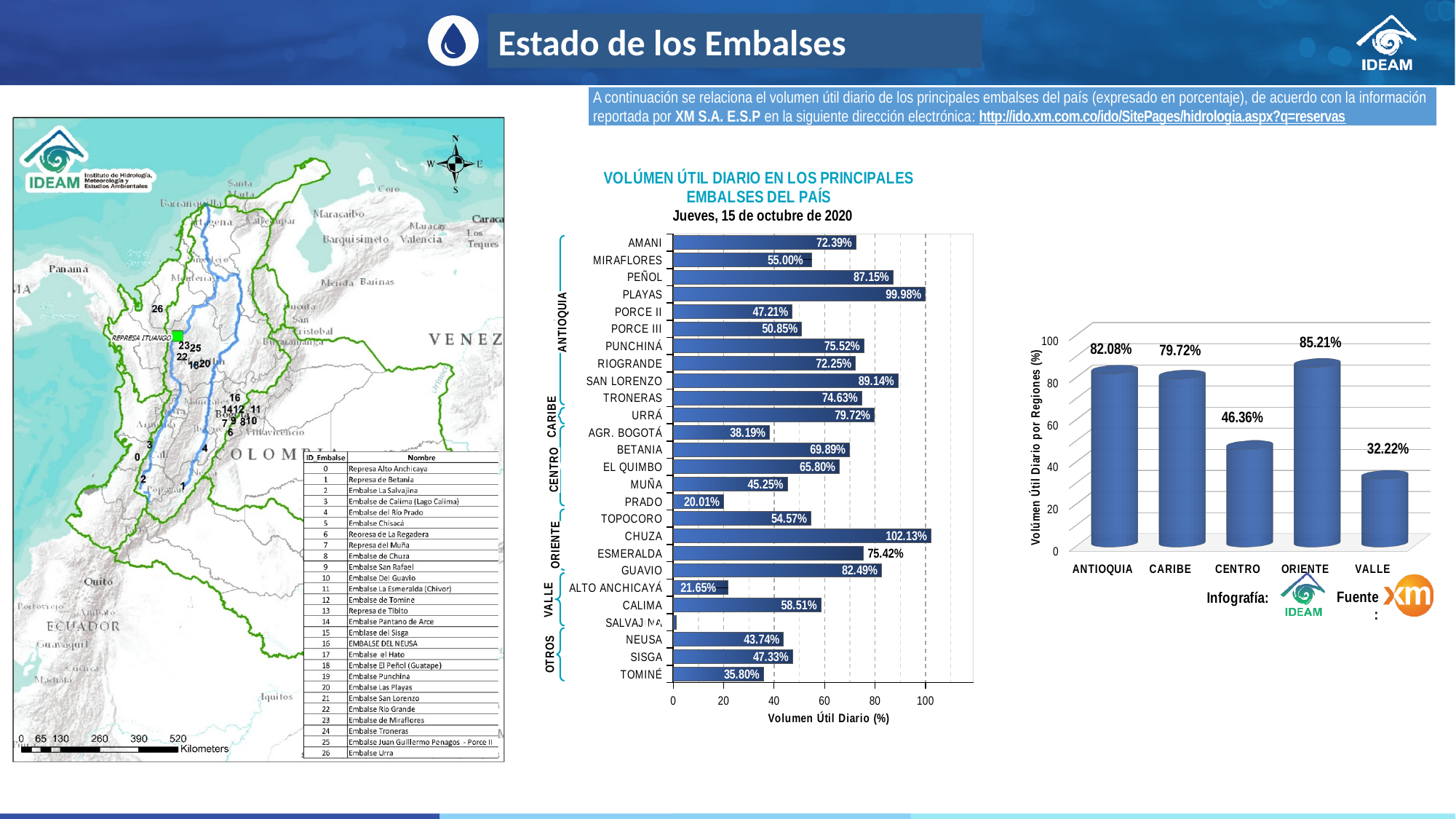
How many regions are shown in the regional chart on the right? 5 In the regional chart on the right, which region has the lowest value? VALLE In the chart 'VOLÚMEN ÚTIL DIARIO EN LOS PRINCIPALES EMBALSES DEL PAÍS', what is the value for PRADO? 20.01% In the regional chart on the right, what is the value for CENTRO? 46.36% In the regional chart on the right, what is the difference between ORIENTE and ANTIOQUIA? 3.13% In the chart 'VOLÚMEN ÚTIL DIARIO EN LOS PRINCIPALES EMBALSES DEL PAÍS', what is the value for CHUZA? 102.13% In the chart 'VOLÚMEN ÚTIL DIARIO EN LOS PRINCIPALES EMBALSES DEL PAÍS', which reservoir has the highest value? CHUZA In the chart 'VOLÚMEN ÚTIL DIARIO EN LOS PRINCIPALES EMBALSES DEL PAÍS', which is larger, BETANIA or EL QUIMBO? BETANIA In the chart 'VOLÚMEN ÚTIL DIARIO EN LOS PRINCIPALES EMBALSES DEL PAÍS', is the value for SALVAJINA greater or less than 20? less In the chart 'VOLÚMEN ÚTIL DIARIO EN LOS PRINCIPALES EMBALSES DEL PAÍS', what is the difference between PLAYAS and PORCE II? 52.77% How many reservoirs are plotted in the chart 'VOLÚMEN ÚTIL DIARIO EN LOS PRINCIPALES EMBALSES DEL PAÍS'? 26 What type of chart is 'VOLÚMEN ÚTIL DIARIO EN LOS PRINCIPALES EMBALSES DEL PAÍS'? Bar chart